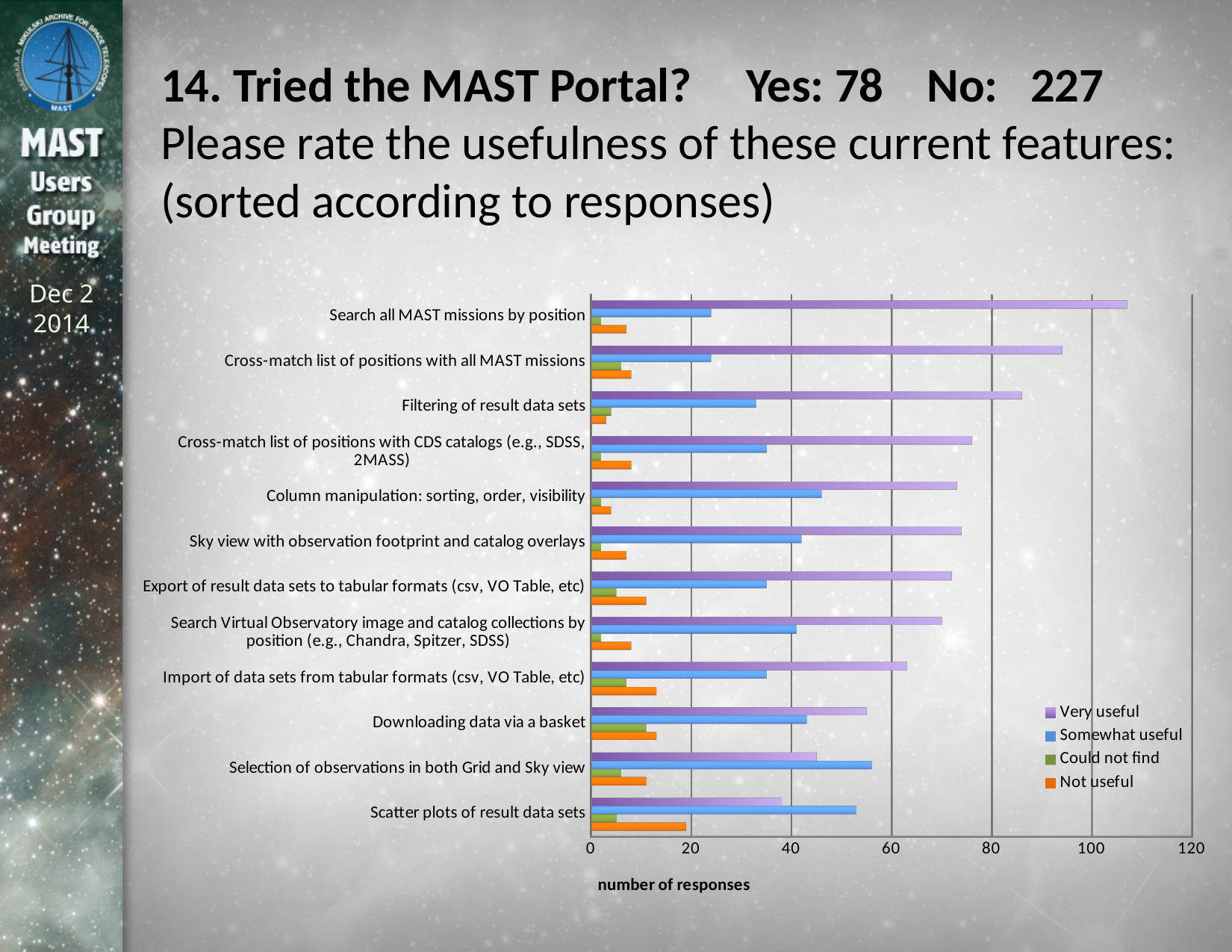
What kind of chart is shown on the slide? bar chart How many series does the chart's legend list? 4 Which feature has the lowest 'Very useful' value? Scatter plots of result data sets Is the 'Somewhat useful' value for 'Scatter plots of result data sets' greater or less than 40? greater For 'Scatter plots of result data sets', which is larger: the 'Very useful' value or the 'Somewhat useful' value? Somewhat useful Is the 'Very useful' value for 'Search all MAST missions by position' greater or less than 100? greater Do the 'Very useful' values generally rise or fall going down the list of features from top to bottom? fall Is the 'Very useful' value for 'Cross-match list of positions with all MAST missions' greater or less than 100? less What is the title of the horizontal axis of the chart? number of responses How many features (categories) are listed on the chart? 12 Which feature has the highest 'Not useful' value? Scatter plots of result data sets Which feature has the highest 'Very useful' value? Search all MAST missions by position